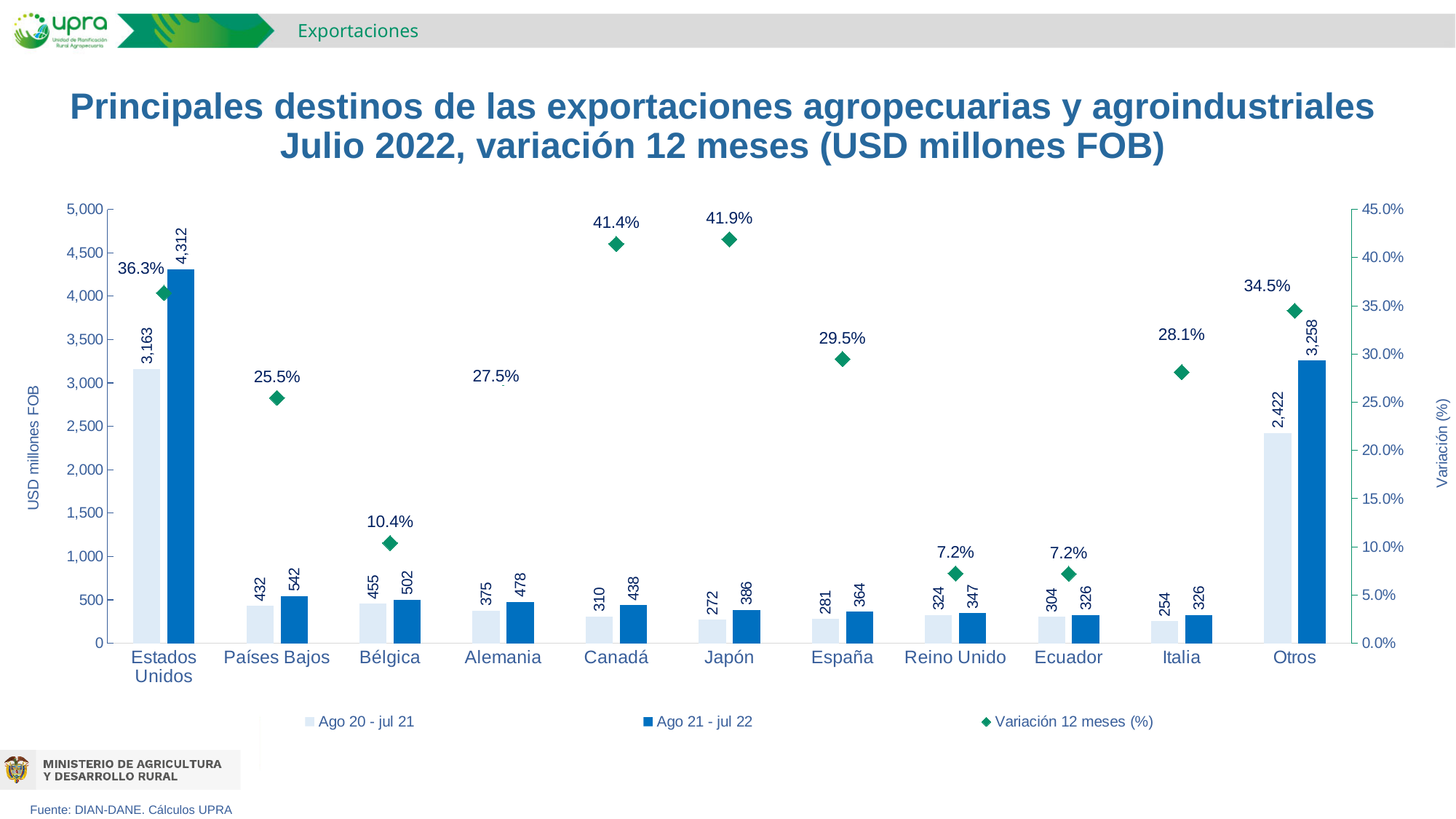
How many destination categories are shown on the x axis? 11 What is the 12-month variation (Variación 12 meses) shown for Bélgica? 10.4% How many series does the legend list? 3 What is the difference between the Ago 21 - jul 22 and Ago 20 - jul 21 values for Estados Unidos? 1,149 Which destination has the lowest value in the Ago 20 - jul 21 series? Italia Which destination has the highest Variación 12 meses (%)? Japón What kind of chart is used to show the export values for each destination? Bar chart What is the label of the right-hand vertical axis? Variación (%) Which is larger: the Ago 21 - jul 22 value for Países Bajos or for Bélgica? Países Bajos What was the value of exports to Estados Unidos in the Ago 21 - jul 22 period? 4,312 What is the difference between the Ago 21 - jul 22 and Ago 20 - jul 21 values for Otros? 836 What was the value of exports to Canadá in the Ago 20 - jul 21 period? 310